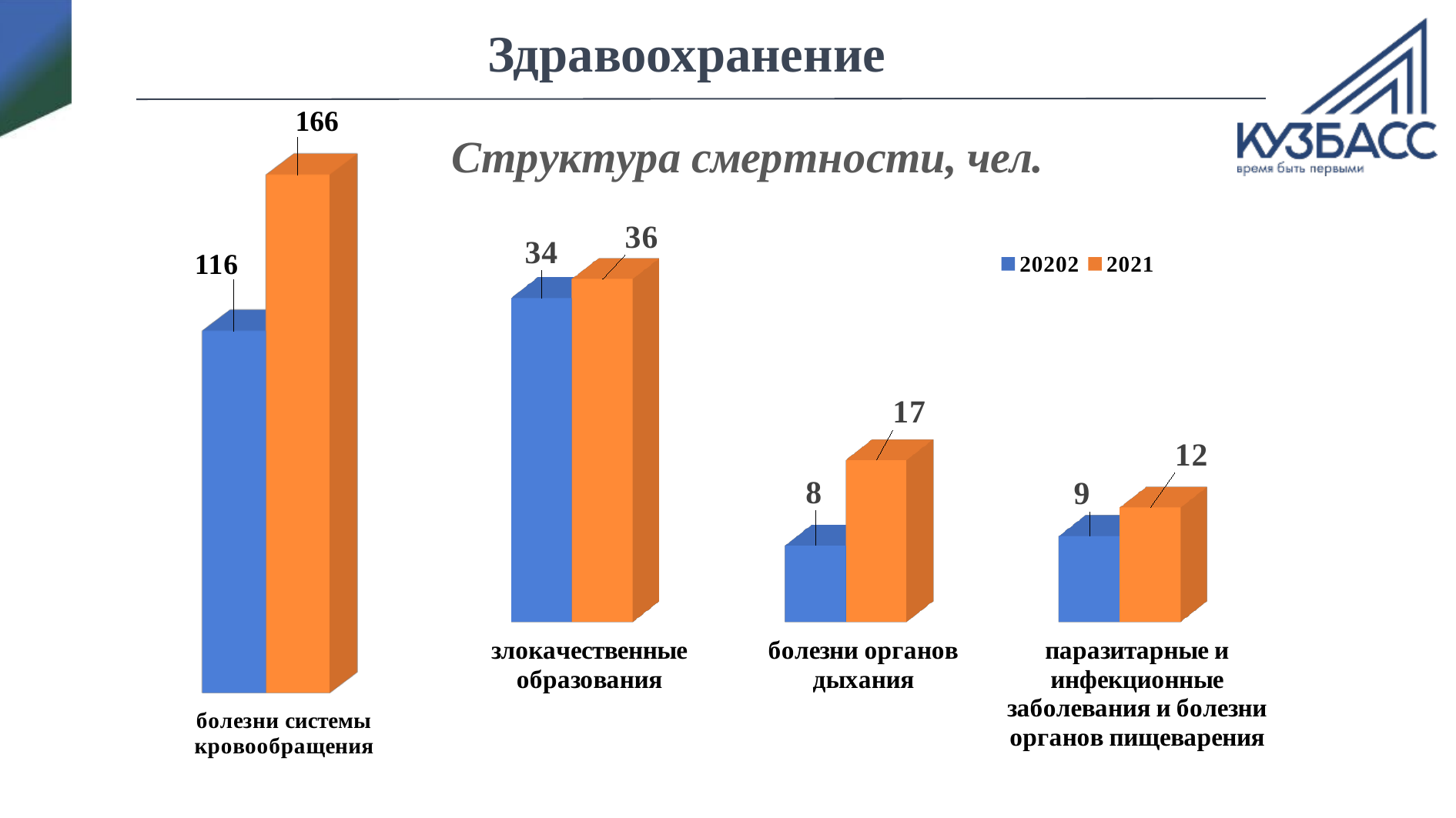
What is the value of the blue series (labelled 20202) for болезни органов дыхания? 8 What is the 2021 value for болезни системы кровообращения? 166 What kind of chart is shown on the slide? bar chart Which is larger: the 2021 value for болезни органов дыхания or the 2021 value for паразитарные и инфекционные заболевания и болезни органов пищеварения? болезни органов дыхания What is the difference between the 2021 values for болезни органов дыхания and паразитарные и инфекционные заболевания и болезни органов пищеварения? 5 What is the value of the blue series (labelled 20202) for паразитарные и инфекционные заболевания и болезни органов пищеварения? 9 How many series does the legend list? 2 How many categories are shown on the chart? 4 What is the 2021 value for злокачественные образования? 36 What is the difference between the 2021 and the blue-series (20202) values for болезни системы кровообращения? 50 Which category has the highest 2021 value? болезни системы кровообращения Which category has the lowest value in the blue series (labelled 20202)? болезни органов дыхания